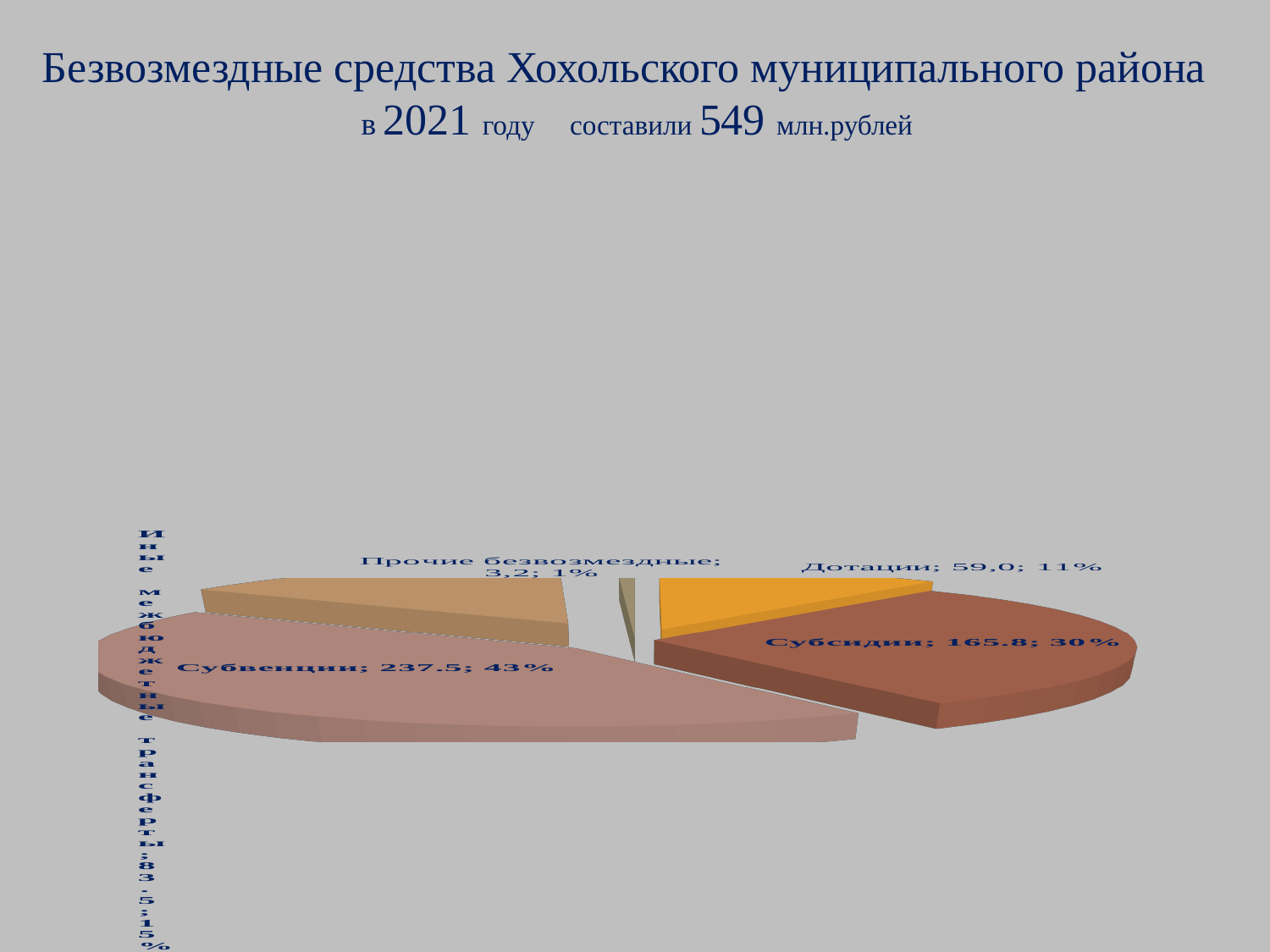
What kind of chart is shown on the slide? pie chart What share of the pie does Субвенции take? 43% How many slices does the pie chart have? 5 Which is larger, the value for Дотации or the value for Субсидии? Субсидии What share of the pie does Субсидии take? 30% What is the difference between the values for Субвенции and Субсидии? 71.7 What is the value for Дотации? 59,0 What is the value for Субвенции? 237.5 Which category has the smallest slice? Прочие безвозмездные Which category has the largest slice? Субвенции What is the value for Прочие безвозмездные? 3,2 What is the value for Субсидии? 165.8